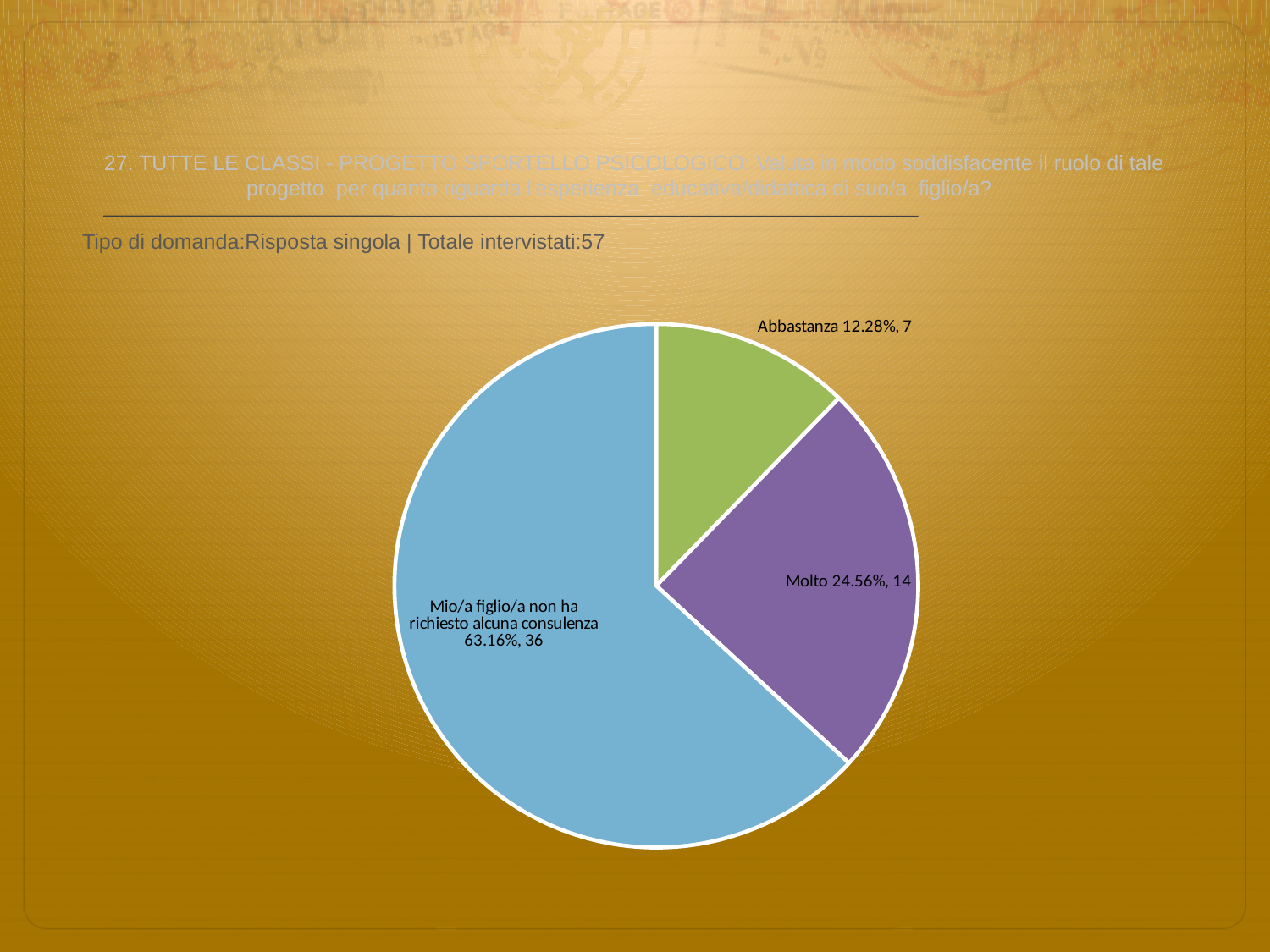
Which slice is the largest? Mio/a figlio/a non ha richiesto alcuna consulenza How many respondents answered 'Abbastanza'? 7 What percentage share does the 'Mio/a figlio/a non ha richiesto alcuna consulenza' slice have? 63.16% How many respondents answered 'Molto'? 14 Which has more respondents, 'Molto' or 'Abbastanza'? Molto Which slice is the smallest? Abbastanza How many respondents answered 'Mio/a figlio/a non ha richiesto alcuna consulenza'? 36 What percentage share does the 'Abbastanza' slice have? 12.28% What kind of chart is shown on the slide? pie chart What is the difference in count between 'Molto' and 'Abbastanza'? 7 How many slices does the pie chart have? 3 What percentage share does the 'Molto' slice have? 24.56%